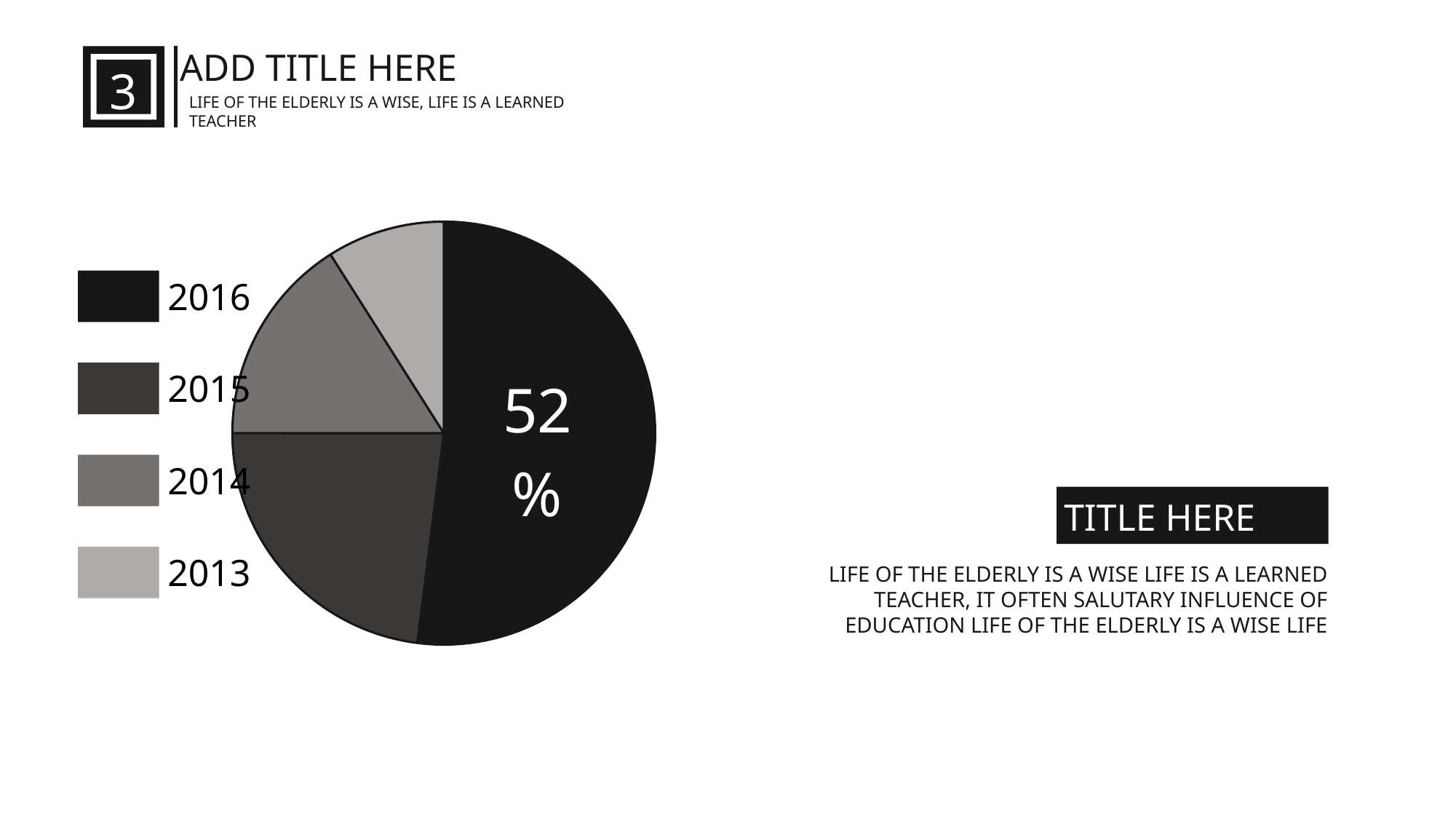
Which years are listed in the legend of the pie chart? 2016, 2015, 2014, 2013 Is the share for 2016 greater or less than 50%? greater What colour is the 2016 slice in the pie chart? black Which slice is larger, 2015 or 2013? 2015 Which year has the smallest slice of the pie chart? 2013 How many entries does the legend list? 4 Which slice is larger, 2016 or 2014? 2016 How many slices does the pie chart have? 4 What percentage is shown for the 2016 slice of the pie chart? 52% Which year has the largest slice of the pie chart? 2016 What kind of chart is shown on the slide? pie chart What share of the pie does the 2016 slice represent? 52%